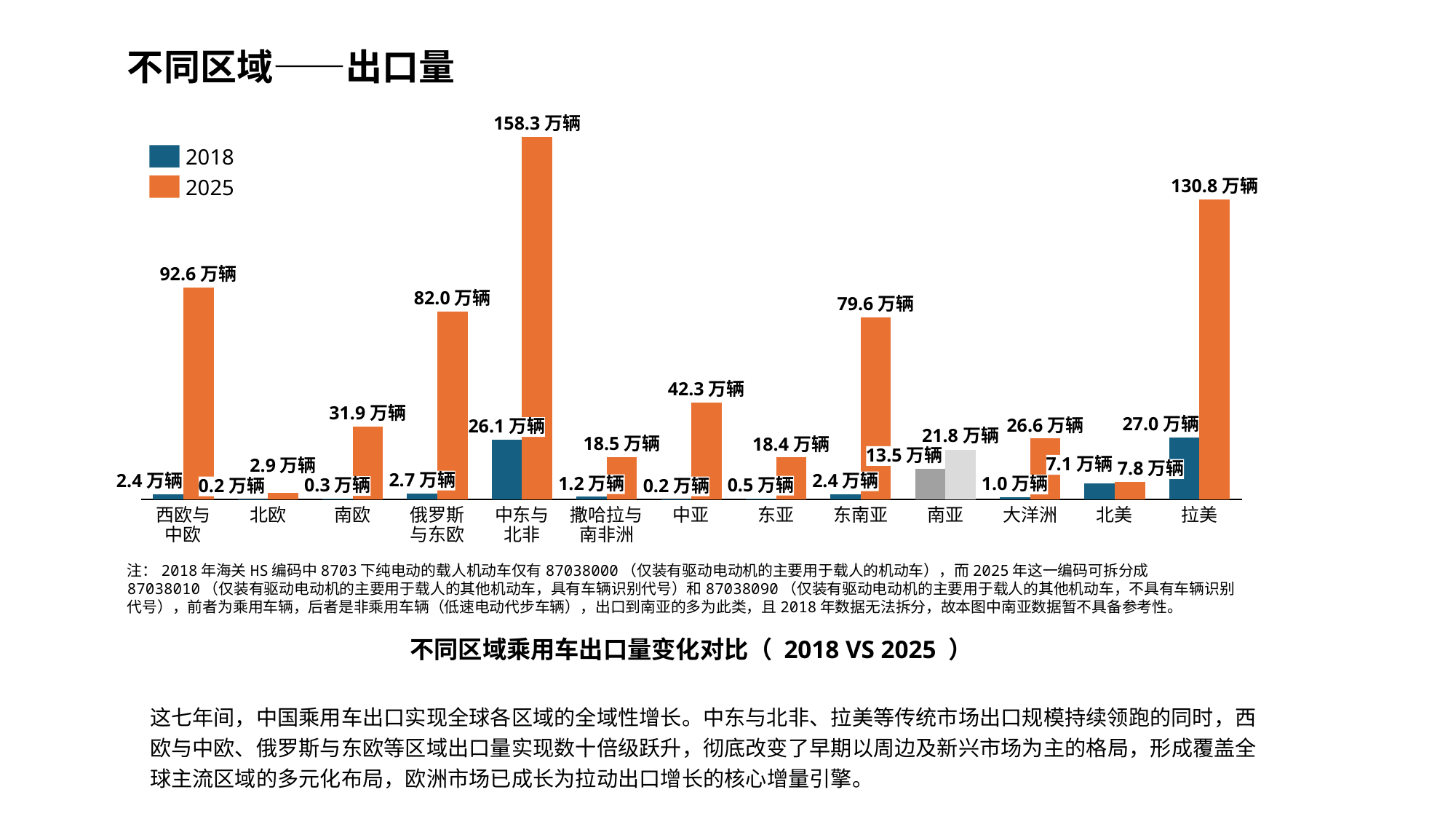
What is the 2018 value for 拉美? 27.0 万辆 Which has a larger 2025 value, 俄罗斯与东欧 or 东南亚? 俄罗斯与东欧 Which region has the lowest 2025 value? 北欧 What is the 2025 value for 中东与北非? 158.3 万辆 What is the 2025 value for 西欧与中欧? 92.6 万辆 Which region has the highest 2025 value? 中东与北非 What is the difference between the 2025 and 2018 values for 拉美? 103.8 万辆 What is the 2018 value for 北美? 7.1 万辆 What is the difference between the 2025 and 2018 values for 中东与北非? 132.2 万辆 How many regions are shown on the x axis? 13 What kind of chart is shown on the slide? Bar chart How many series does the legend list? 2